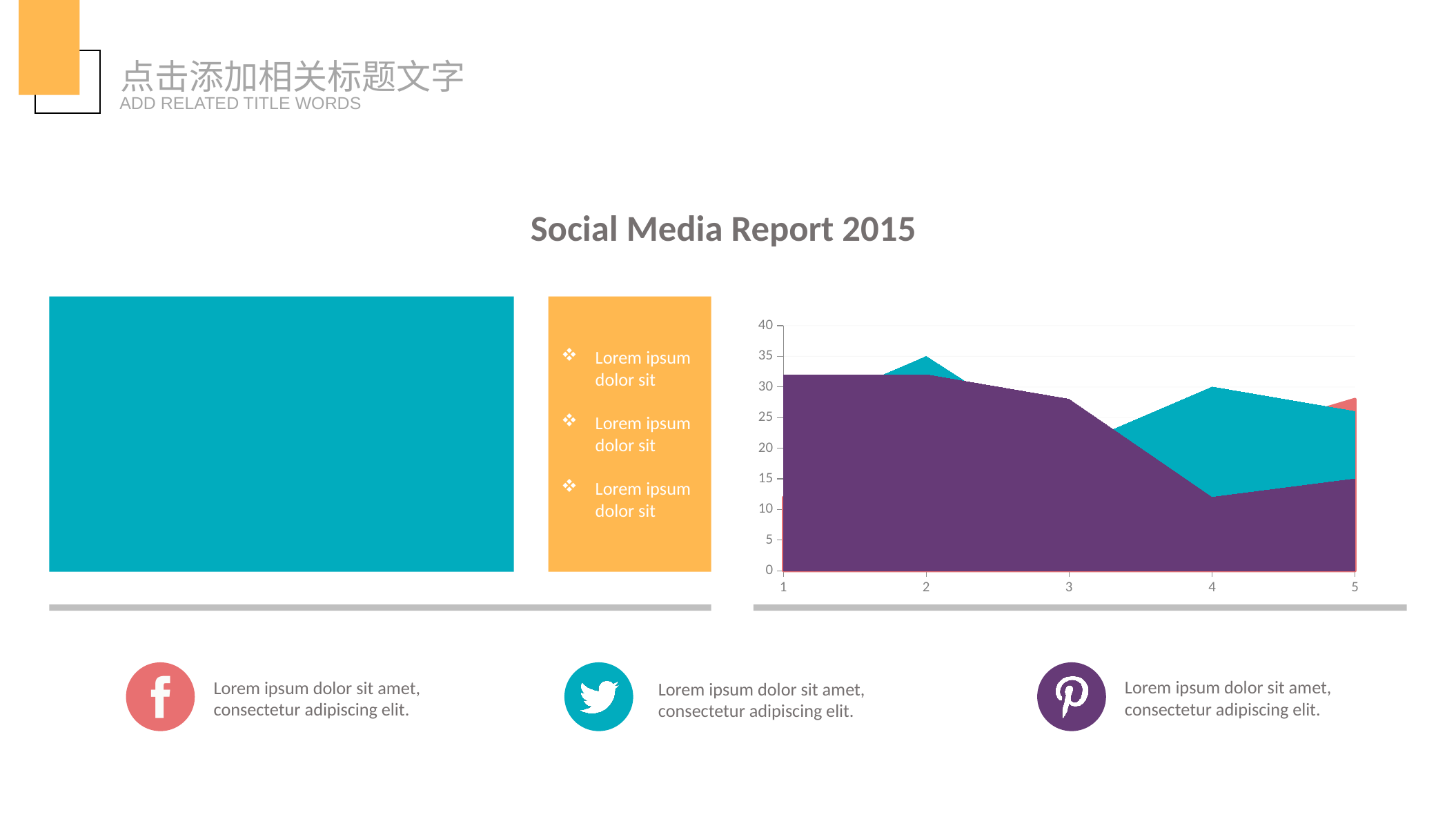
What is the highest value shown on the y axis of the chart? 40 Is the value of the teal series at x = 4 greater or less than 25? greater Does the purple series generally rise or fall from x = 1 to x = 4? fall How many points are labelled along the x axis of the chart? 5 What kind of chart is shown on the slide? area chart Is the value of the purple series at x = 1 greater or less than 30? greater What is the title shown above the chart? Social Media Report 2015 At which x-axis point does the purple series reach its lowest value? 4 Is the value of the teal series at x = 2 greater or less than 30? greater Which is larger for the purple series: the value at x = 1 or the value at x = 4? x = 1